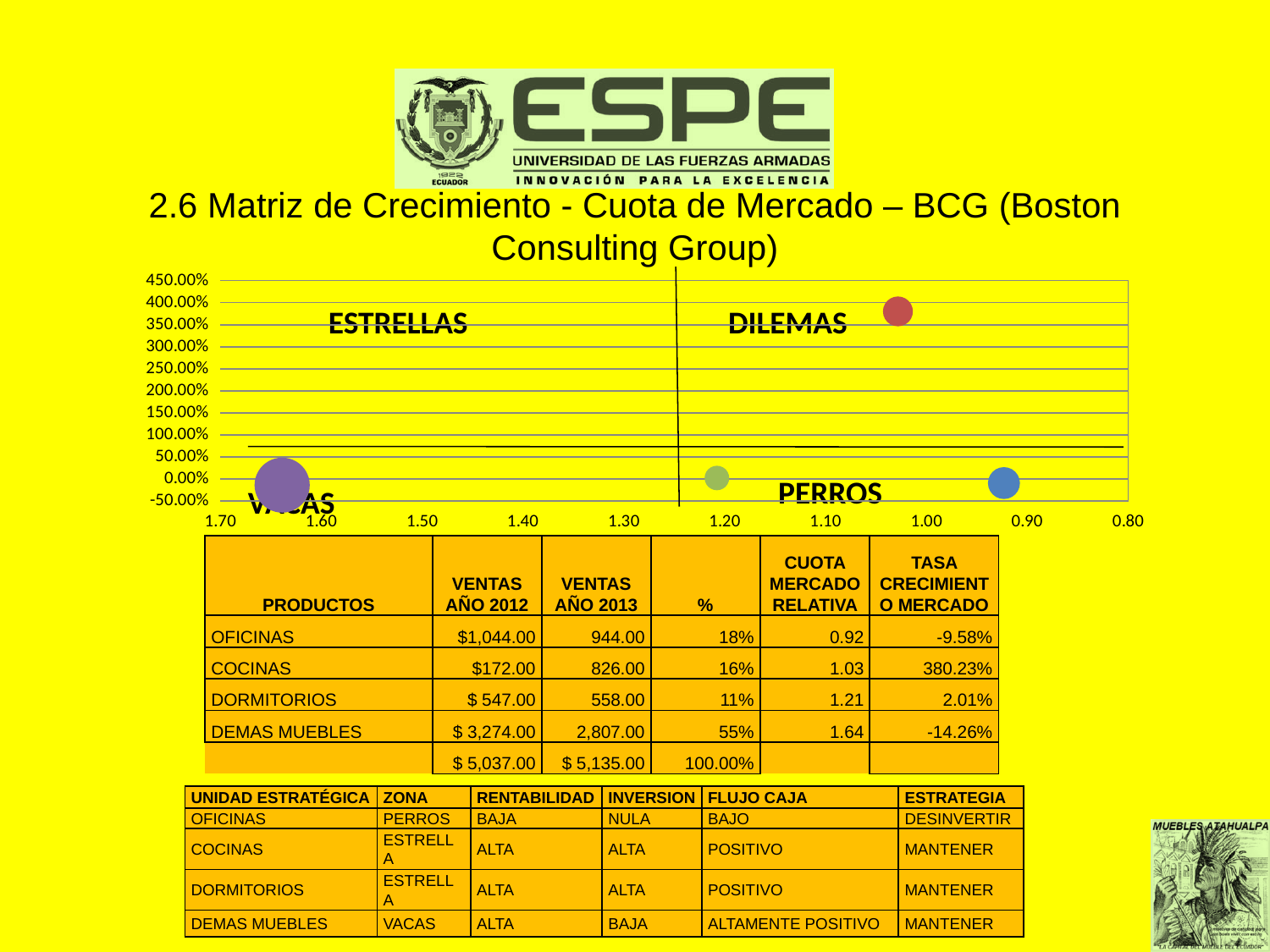
Is the horizontal-axis value of the blue bubble greater or less than 1.00? less Which bubble is positioned highest on the vertical axis? the red bubble What are the four quadrant labels shown on the chart? ESTRELLAS, DILEMAS, VACAS, PERROS Is the horizontal-axis value of the large purple bubble greater or less than 1.50? greater Which bubble is the largest in size on the chart? the purple bubble What kind of chart is shown on the slide? bubble chart Which bubble is positioned higher on the vertical axis, the red bubble or the blue bubble? the red bubble What is the highest value shown on the chart's vertical axis? 450.00% How many bubbles are plotted on the chart? 4 Is the vertical-axis value of the red bubble greater or less than 300.00%? greater